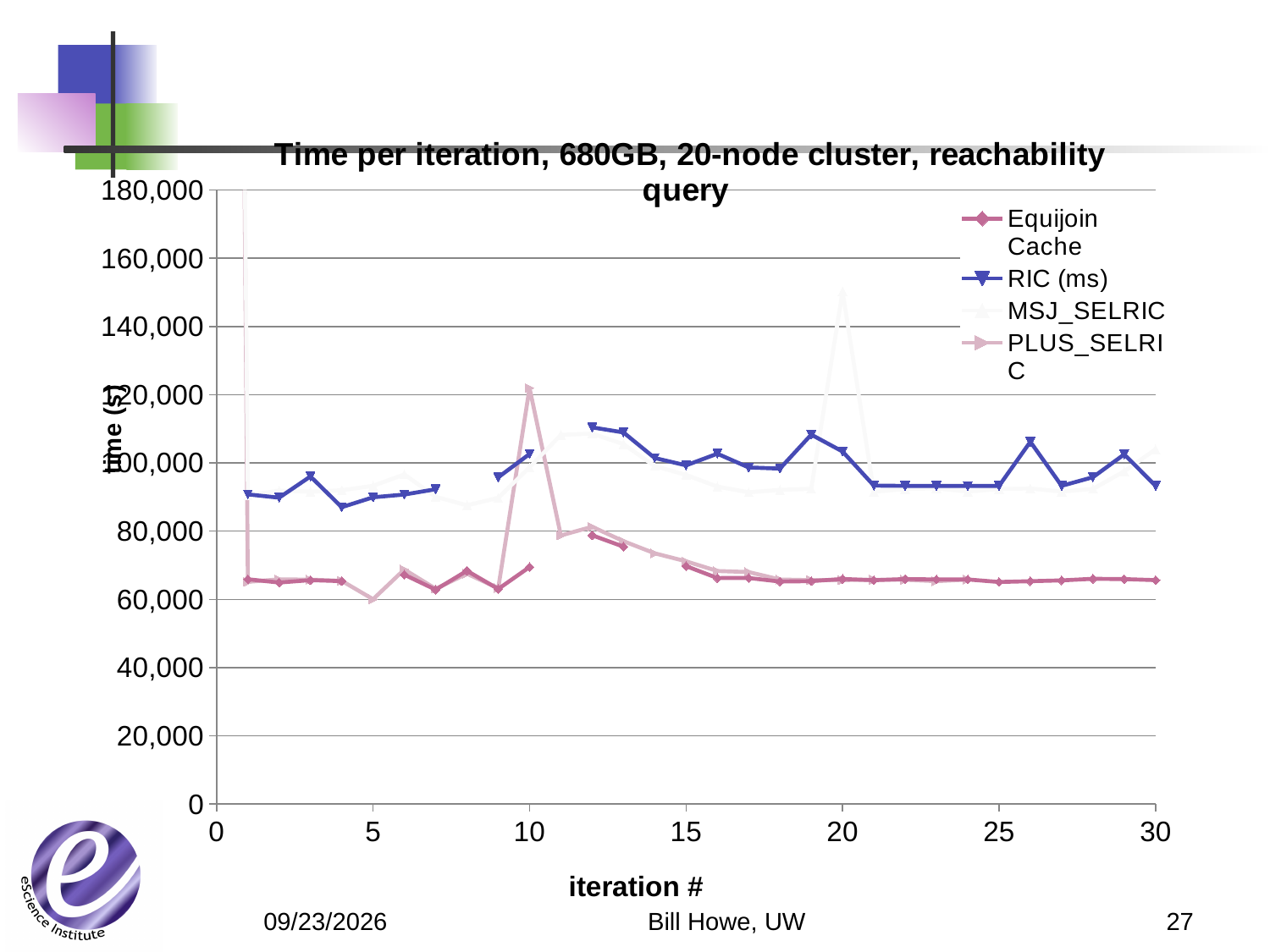
Do the Equijoin Cache values rise or fall from iteration 12 to iteration 18? fall What is the label of the x axis? iteration # What is the highest value shown on the y axis? 180,000 Is the value for Equijoin Cache at iteration 20 greater or less than 80,000? less Is the value for RIC (ms) at iteration 4 greater or less than 100,000? less What is the title of the chart? Time per iteration, 680GB, 20-node cluster, reachability query Is the value for Equijoin Cache at iteration 20 greater or less than 60,000? greater How many series does the legend list? 4 What kind of chart is shown on the slide? line chart At iteration 20, which is larger: RIC (ms) or Equijoin Cache? RIC (ms)